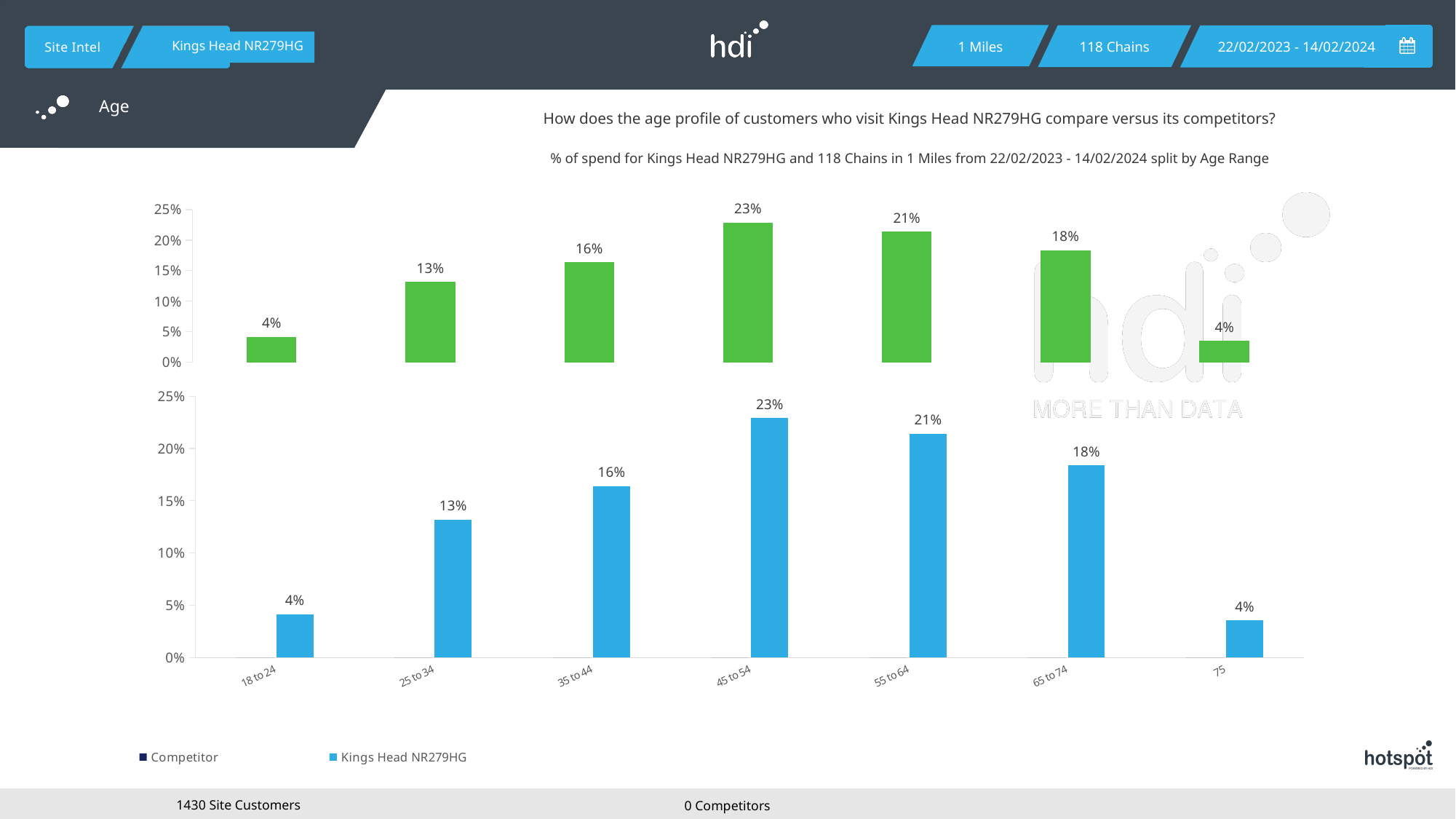
In the bottom chart, what is the value for the 65 to 74 age range? 18% How many age range categories are shown on the x axis of the bottom chart? 7 How many series does the legend list? 2 What kind of chart is the bottom chart? bar chart What are the two series names listed in the legend? Competitor and Kings Head NR279HG In the bottom chart, do the values rise or fall from 45 to 54 through to 75? fall In the bottom chart, which is larger, the value for 35 to 44 or the value for 55 to 64? 55 to 64 In the top chart, what is the value for the 25 to 34 age range? 13% In the top chart, what is the difference between the values for 45 to 54 and 18 to 24? 19% In the bottom chart, is the value for 25 to 34 greater or less than 10%? greater In the bottom chart, which age range has the highest value? 45 to 54 In the bottom chart, what is the value for the 45 to 54 age range? 23%